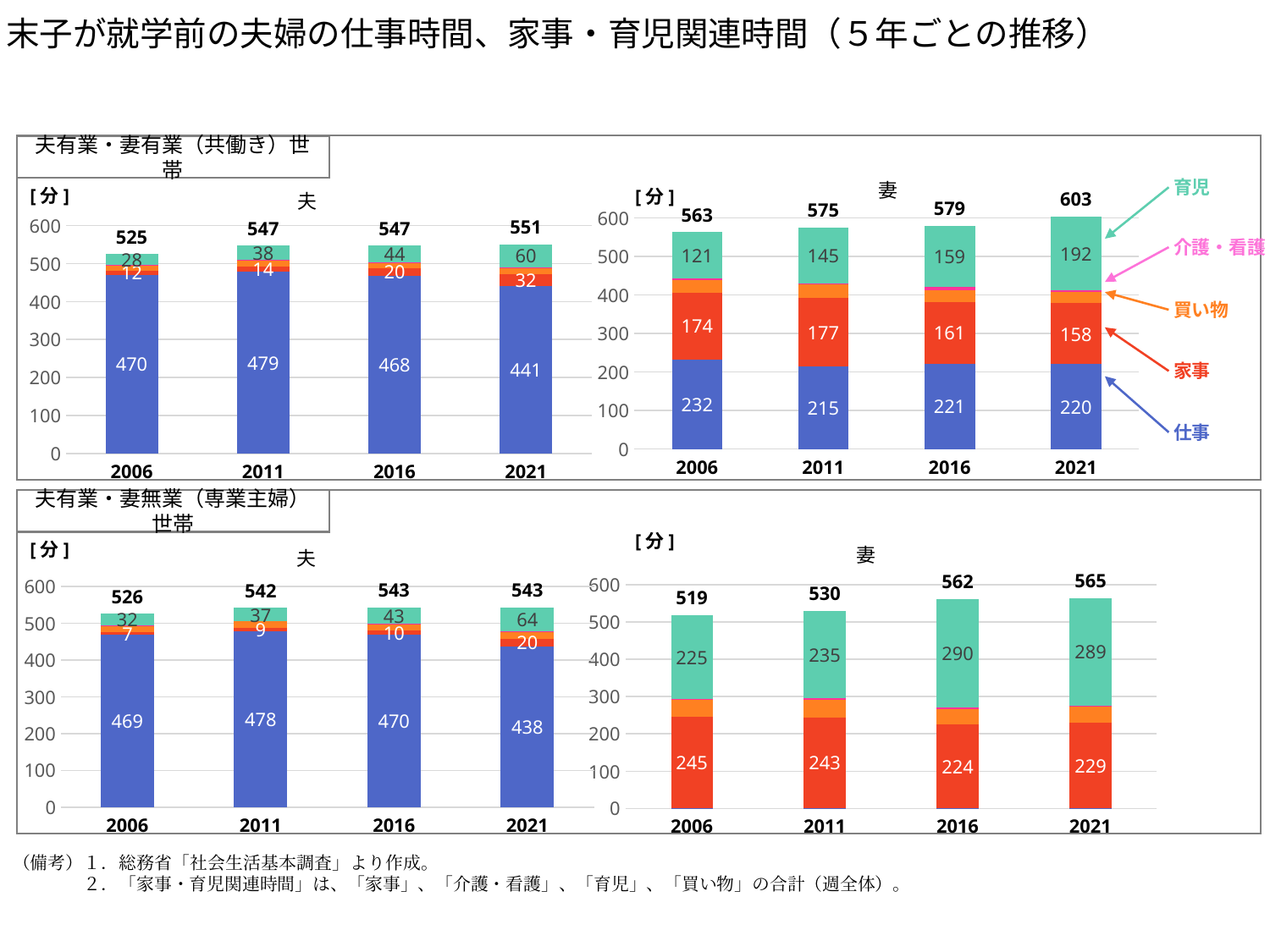
What kind of chart is the top-right chart (共働き世帯, 妻)? Stacked bar chart How many years are plotted in the bottom-left chart (専業主婦世帯, 夫)? 4 In the top-left chart (共働き世帯, 夫), what is the total of the stacked bar for 2021? 551 In the bottom-left chart (専業主婦世帯, 夫), what is the value for 家事 in 2021? 20 How many categories does the legend on the right of the slide list? 5 In the top-left chart (共働き世帯, 夫), what is the difference between the 仕事 value in 2006 and in 2021? 29 In the bottom-right chart (専業主婦世帯, 妻), what is the value for 育児 in 2016? 290 In the top-right chart (共働き世帯, 妻), what is the value for 育児 in 2021? 192 In the bottom-right chart (専業主婦世帯, 妻), which year has the larger 家事 value, 2006 or 2021? 2006 In the bottom-right chart (専業主婦世帯, 妻), which year has the lowest total? 2006 In the top-right chart (共働き世帯, 妻), which year has the highest total? 2021 In the top-right chart (共働き世帯, 妻), do the bar totals rise or fall from 2006 to 2021? Rise